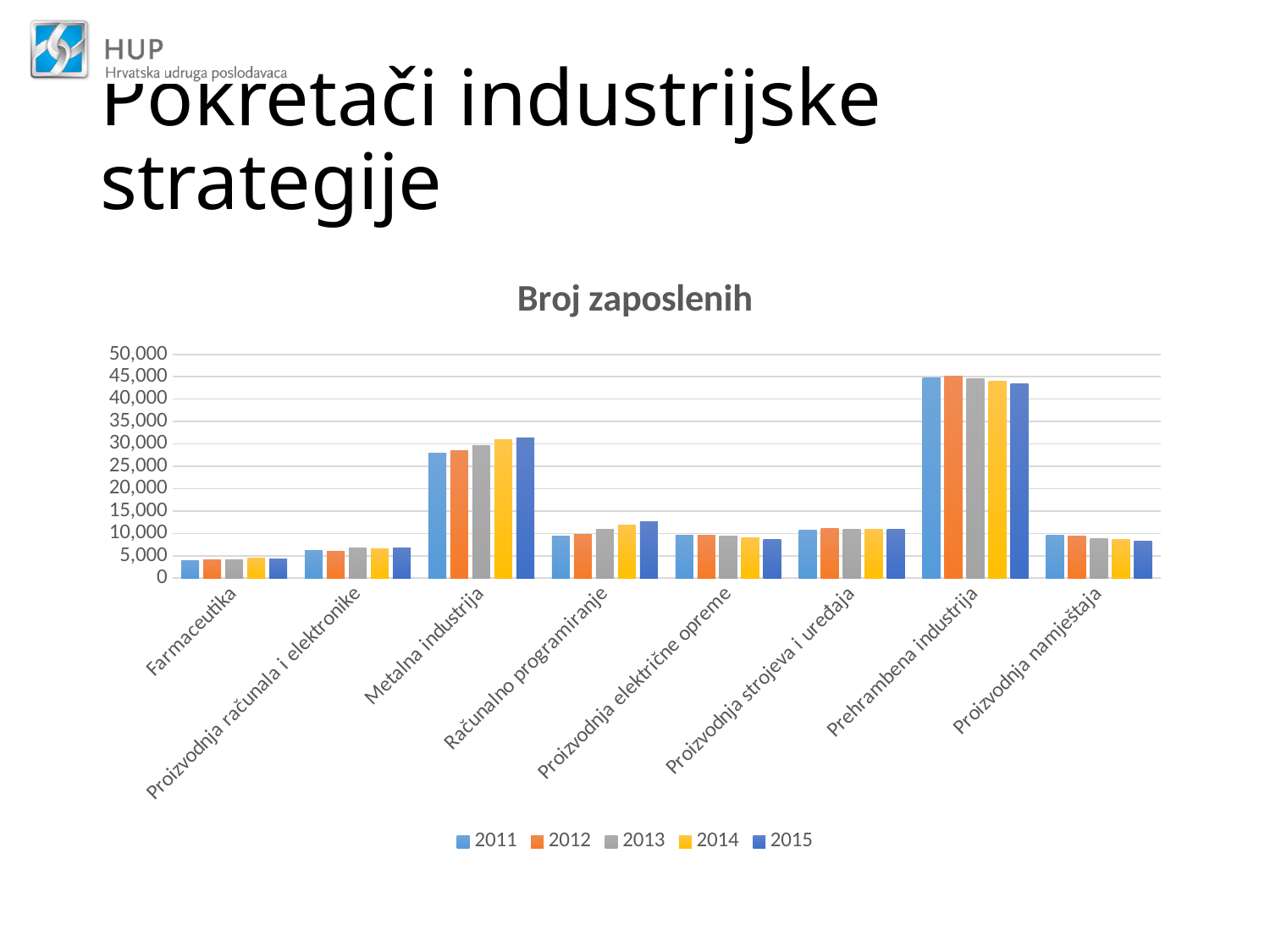
Which category has the highest number of employees in the "Broj zaposlenih" chart? Prehrambena industrija What kind of chart is shown under the title "Broj zaposlenih"? bar chart Do the values for Metalna industrija rise or fall from 2011 to 2015? rise How many series does the legend of the "Broj zaposlenih" chart list? 5 Is the 2015 value for Metalna industrija greater or less than 25,000? greater How many industry categories are shown on the x axis of the "Broj zaposlenih" chart? 8 What years does the legend of the "Broj zaposlenih" chart list? 2011, 2012, 2013, 2014, 2015 Is the 2011 value for Farmaceutika greater or less than 5,000? less Is the 2015 value for Računalno programiranje greater or less than 10,000? greater Which has more employees in 2013, Metalna industrija or Računalno programiranje? Metalna industrija Which category has the lowest number of employees in the "Broj zaposlenih" chart? Farmaceutika